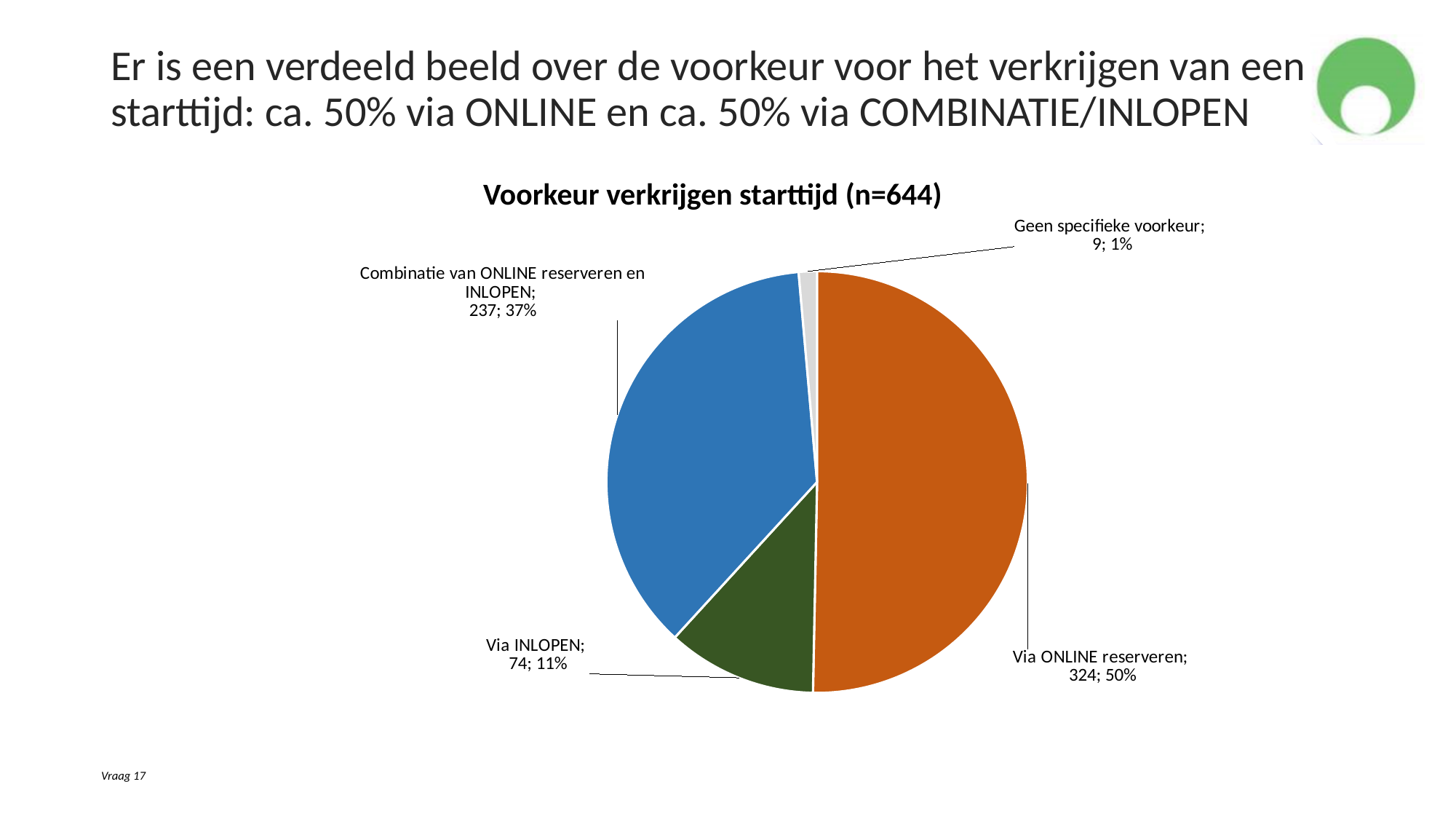
Which category has the smallest slice? Geen specifieke voorkeur How many respondents chose 'Via INLOPEN'? 74 What is the title of the chart? Voorkeur verkrijgen starttijd (n=644) What share of the pie is 'Geen specifieke voorkeur'? 1% What is the difference in count between 'Via ONLINE reserveren' and 'Combinatie van ONLINE reserveren en INLOPEN'? 87 What kind of chart is shown on the slide? pie chart How many slices does the pie chart have? 4 What share of the pie is 'Combinatie van ONLINE reserveren en INLOPEN'? 37% What colour is the 'Via INLOPEN' slice? dark green Which is larger: 'Via INLOPEN' or 'Combinatie van ONLINE reserveren en INLOPEN'? Combinatie van ONLINE reserveren en INLOPEN How many respondents chose 'Via ONLINE reserveren'? 324 Which category has the largest slice? Via ONLINE reserveren